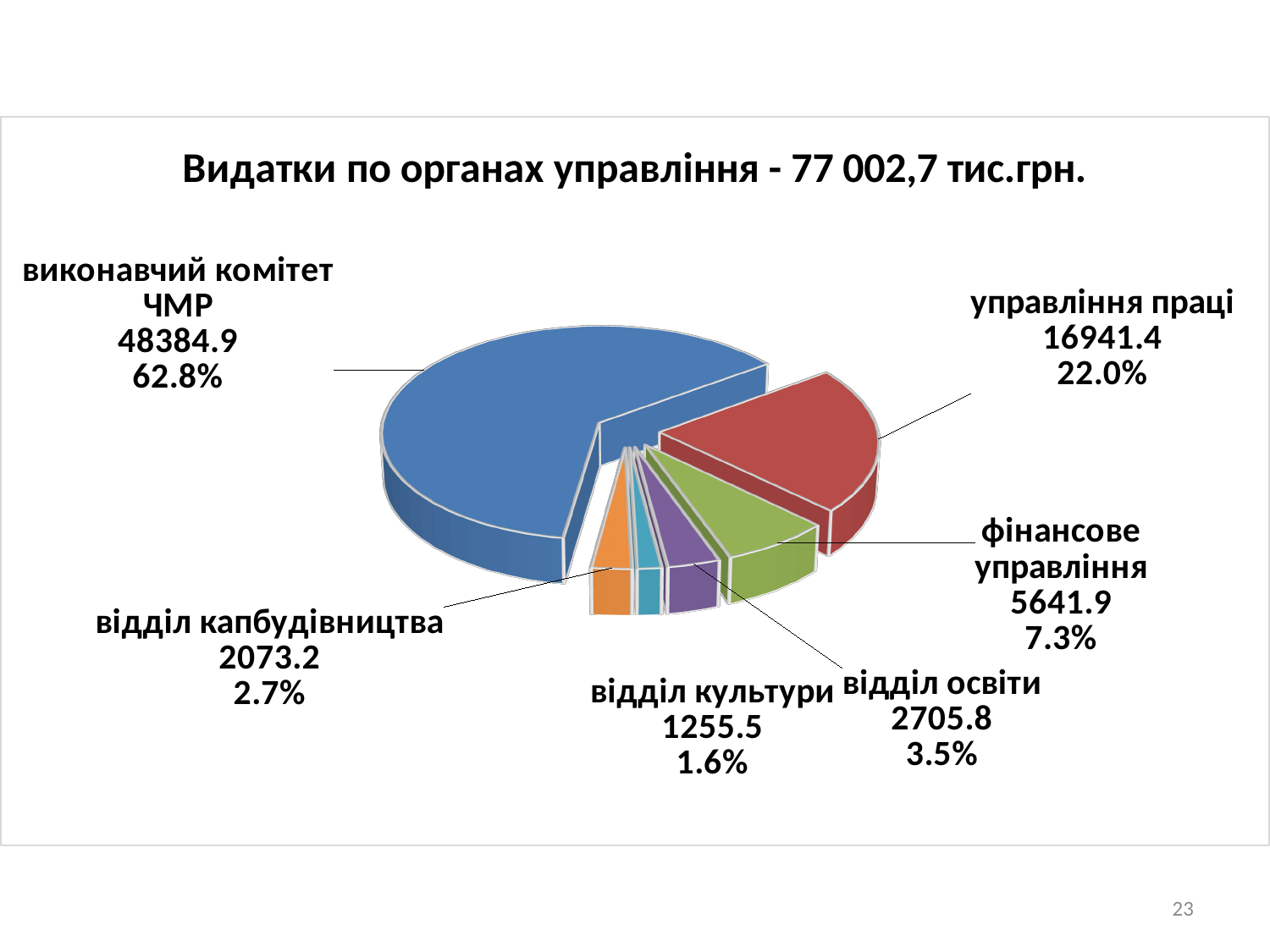
What is the value for виконавчий комітет ЧМР? 48384.9 Which category has the largest slice? виконавчий комітет ЧМР What colour is the slice for виконавчий комітет ЧМР? blue Which is larger, the value for відділ освіти or the value for відділ капбудівництва? відділ освіти Which category has the smallest slice? відділ культури What is the title of the chart? Видатки по органах управління - 77 002,7 тис.грн. What is the difference between the values for управління праці and фінансове управління? 11299.5 How many slices does the pie chart have? 6 What is the value for фінансове управління? 5641.9 What kind of chart is shown on the slide? pie chart What share of the pie does відділ культури represent? 1.6% What share of the pie does управління праці represent? 22.0%